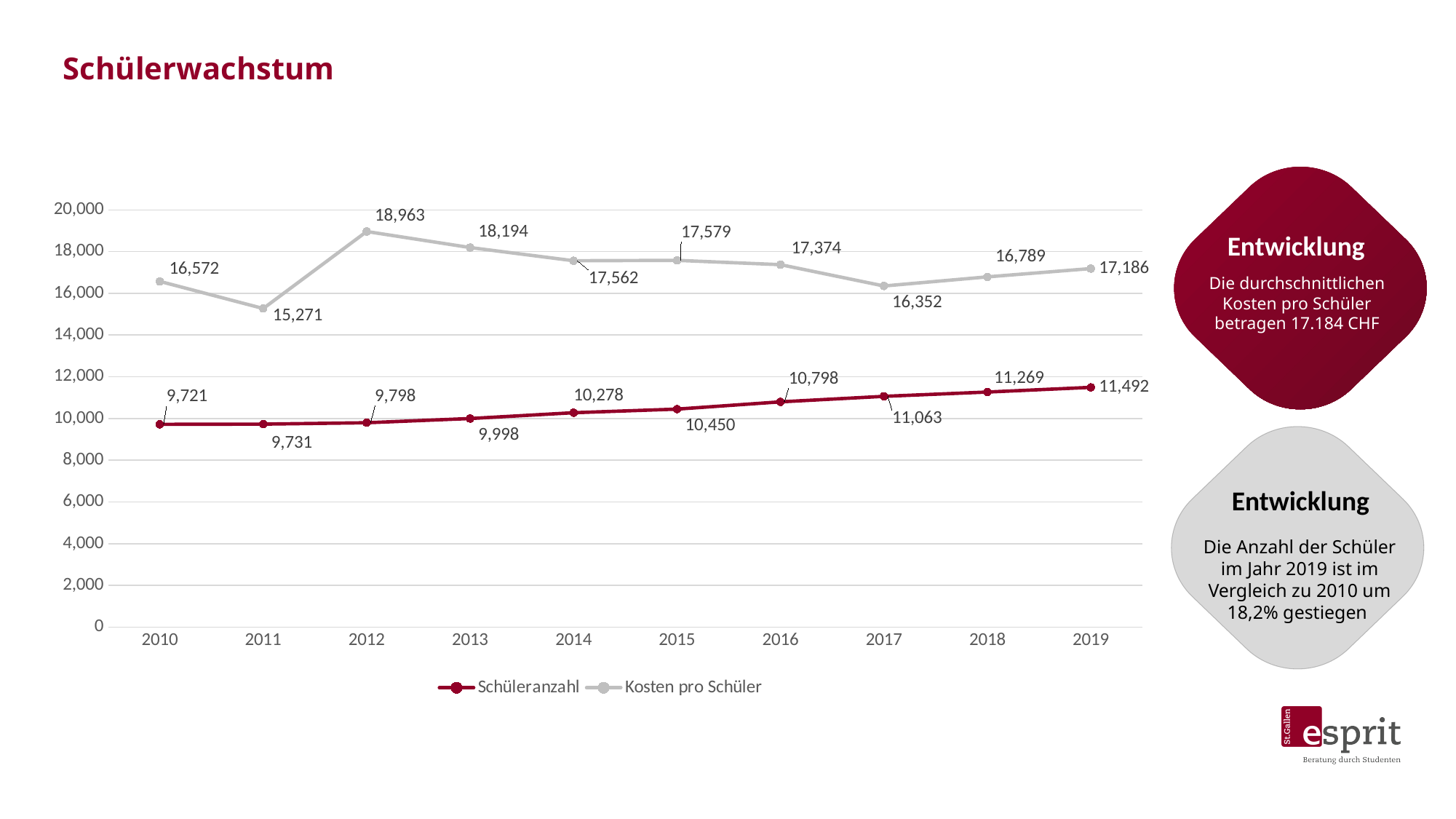
What is the difference between the Schüleranzahl values for 2019 and 2010? 1,771 What kind of chart is shown on the slide? line chart What is the Schüleranzahl value for 2015? 10,450 Which is larger, Kosten pro Schüler in 2017 or in 2018? 2018 How many years are shown on the x axis? 10 In which year is Kosten pro Schüler highest? 2012 How many series does the legend list? 2 What is the Kosten pro Schüler value for 2012? 18,963 In which year is Kosten pro Schüler lowest? 2011 In which year is Schüleranzahl lowest? 2010 What is the Kosten pro Schüler value for 2019? 17,186 What is the difference between the Kosten pro Schüler values for 2012 and 2011? 3,692